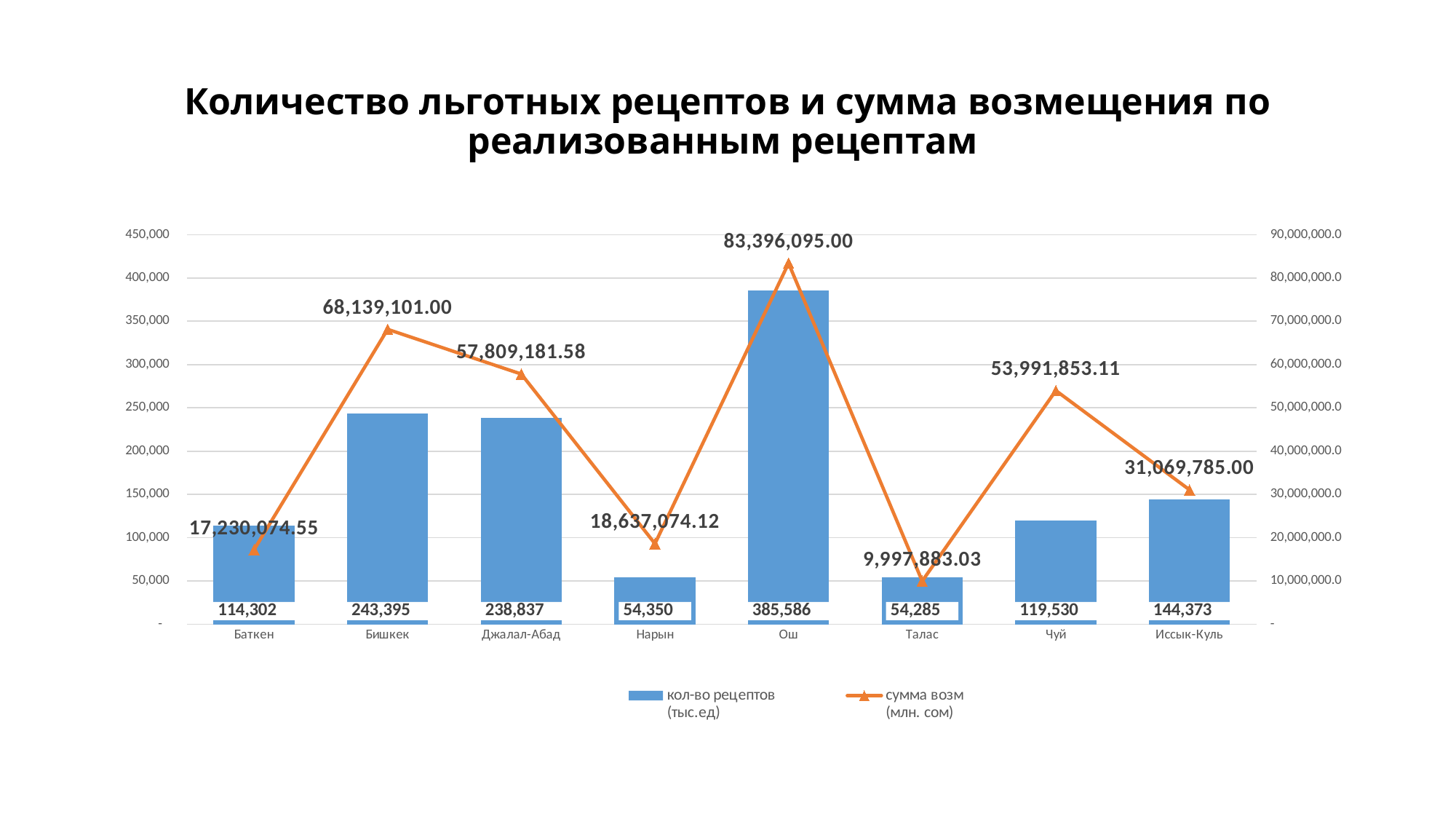
Which region has the larger reimbursement amount, Чуй or Иссык-Куль? Чуй What is the title of the chart? Количество льготных рецептов и сумма возмещения по реализованным рецептам What is the difference in the number of prescriptions between Бишкек and Джалал-Абад? 4,558 How many series does the legend list? 2 What is the number of prescriptions (кол-во рецептов) for Иссык-Куль? 144,373 What is the number of prescriptions (кол-во рецептов) for Ош? 385,586 What is the reimbursement amount (сумма возм) for Талас? 9,997,883.03 What is the reimbursement amount (сумма возм) for Бишкек? 68,139,101.00 Which region has the lowest reimbursement amount (сумма возм)? Талас Which region has the highest number of prescriptions (кол-во рецептов)? Ош What kinds of chart are combined on this slide? Bar chart and line chart How many regions are shown on the x axis? 8